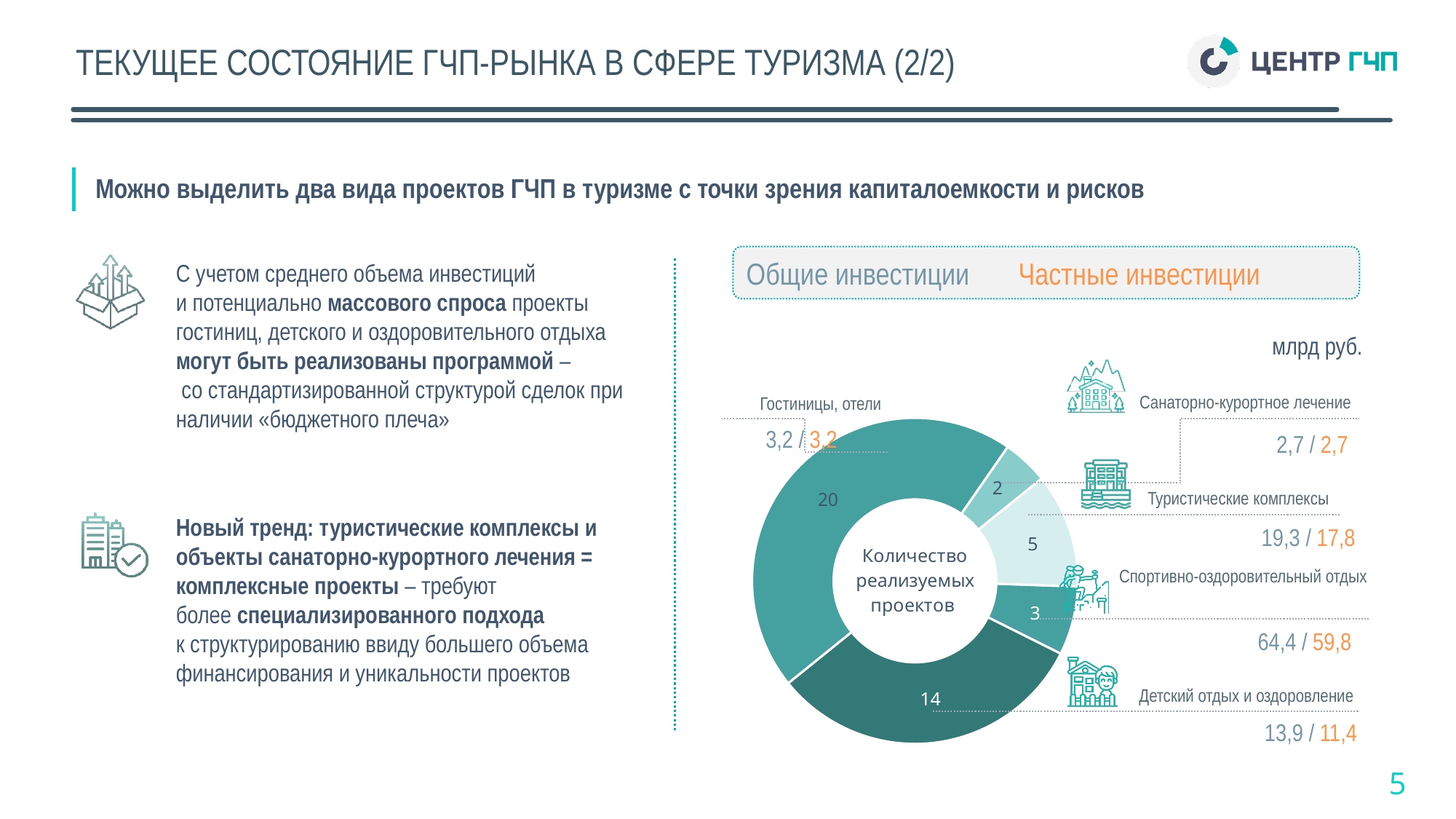
Which has more implemented projects: "Туристические комплексы" or "Спортивно-оздоровительный отдых"? Туристические комплексы What text is written in the centre of the donut chart? Количество реализуемых проектов What is the total number of implemented projects across all slices of the donut chart? 44 How many projects are being implemented in the category "Детский отдых и оздоровление"? 14 What is the difference in the number of projects between "Гостиницы, отели" and "Детский отдых и оздоровление"? 6 How many projects are being implemented in the category "Гостиницы, отели"? 20 What is the total investment (Общие инвестиции) value for "Туристические комплексы", in млрд руб.? 19,3 What kind of chart is shown on the right side of the slide? pie chart (donut) How many categories are shown in the donut chart? 5 Which category has the smallest number of implemented projects? Санаторно-курортное лечение Which category has the largest number of implemented projects? Гостиницы, отели What is the private investment (Частные инвестиции) value for "Спортивно-оздоровительный отдых", in млрд руб.? 59,8